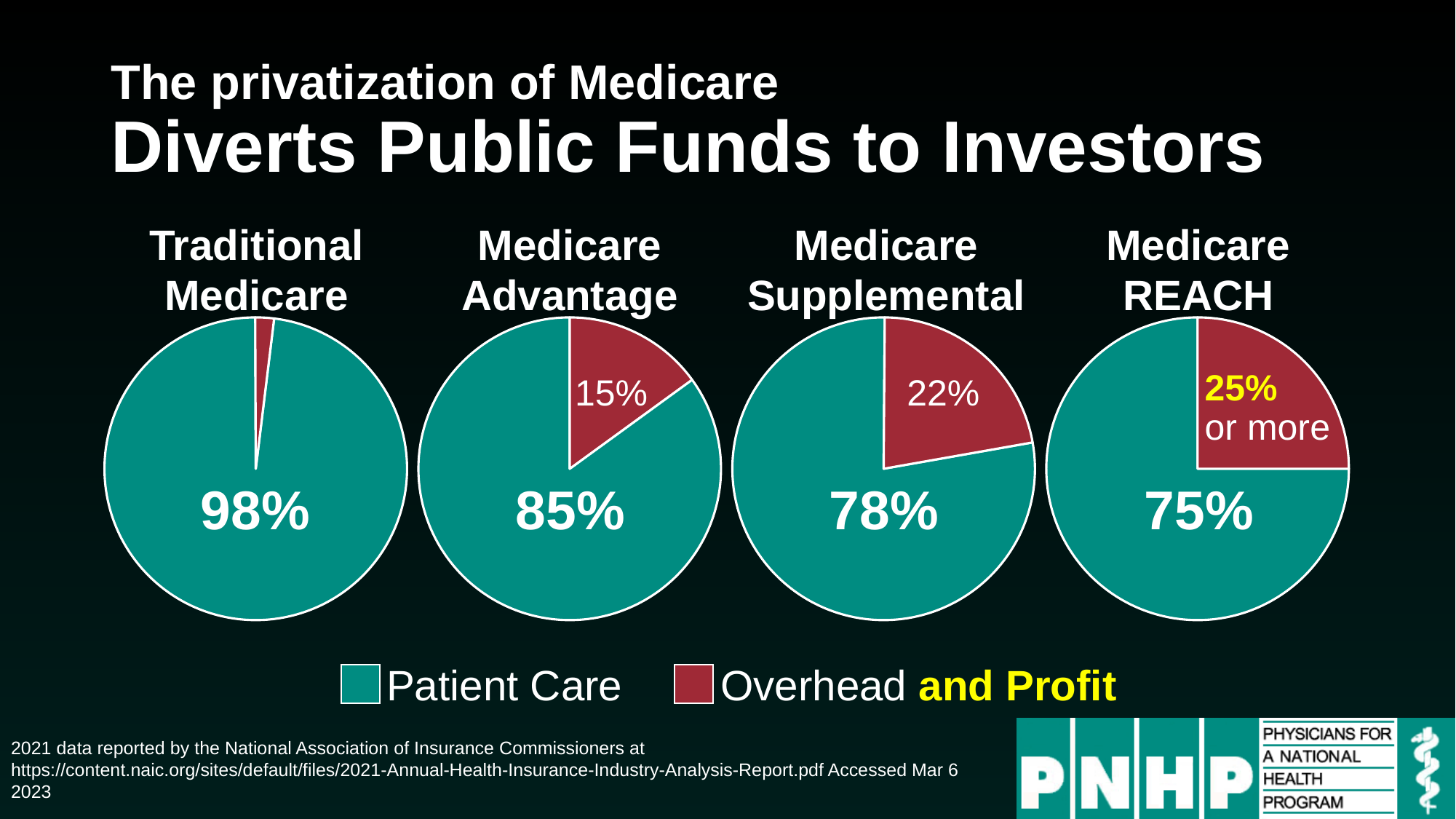
Which pie chart shows the highest Patient Care share? Traditional Medicare In the Medicare Supplemental pie chart, what share goes to Patient Care? 78% How many series does the legend list? 2 In the Medicare Supplemental pie chart, what share goes to Overhead and Profit? 22% What is the difference between the Patient Care share in the Medicare Advantage chart and the Medicare Supplemental chart? 7% How many pie charts are on the slide? 4 In the Medicare REACH pie chart, what share goes to Patient Care? 75% In the Traditional Medicare pie chart, what share goes to Patient Care? 98% What kind of charts are shown on the slide? Pie charts In the Medicare Advantage pie chart, what share goes to Overhead and Profit? 15% Which legend entry is shown in red? Overhead and Profit Which pie chart shows the lowest Patient Care share? Medicare REACH